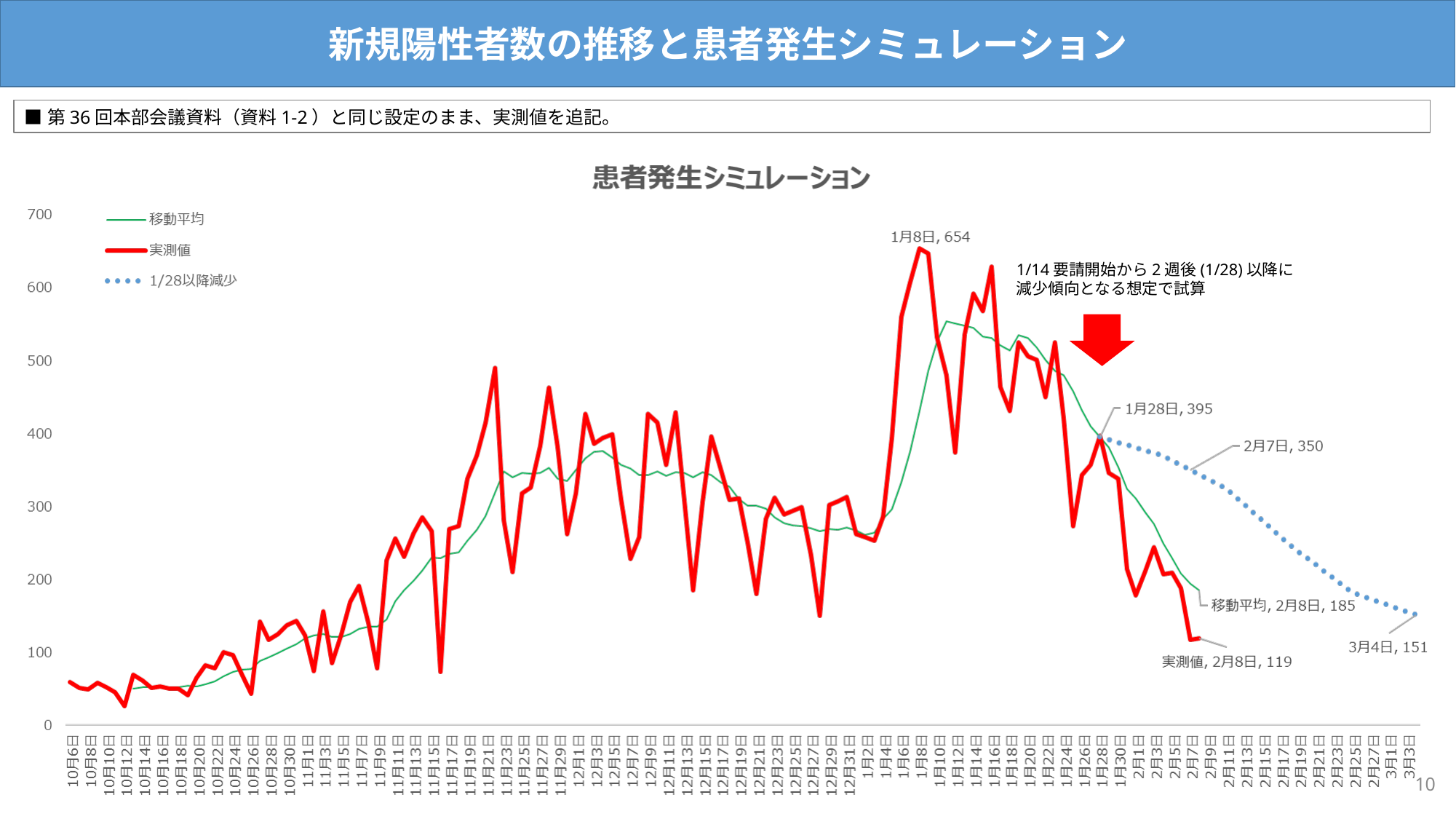
What is the labelled value of the 1/28以降減少 series on 3月4日? 151 Which is larger on 2月8日: the 移動平均 value or the 実測値 value? 移動平均 What is the title of the chart? 患者発生シミュレーション What is the labelled value of the 1/28以降減少 series on 2月7日? 350 What is the labelled value of 実測値 on 1月8日? 654 What type of chart is shown on the slide? line chart What is the labelled value of 移動平均 on 2月8日? 185 What is the labelled value of 実測値 on 2月8日? 119 What is the difference between the 移動平均 value and the 実測値 value on 2月8日? 66 How many series does the chart legend list? 3 Is the 実測値 value on 1月8日 greater or less than 600? greater What is the labelled value on 1月28日? 395